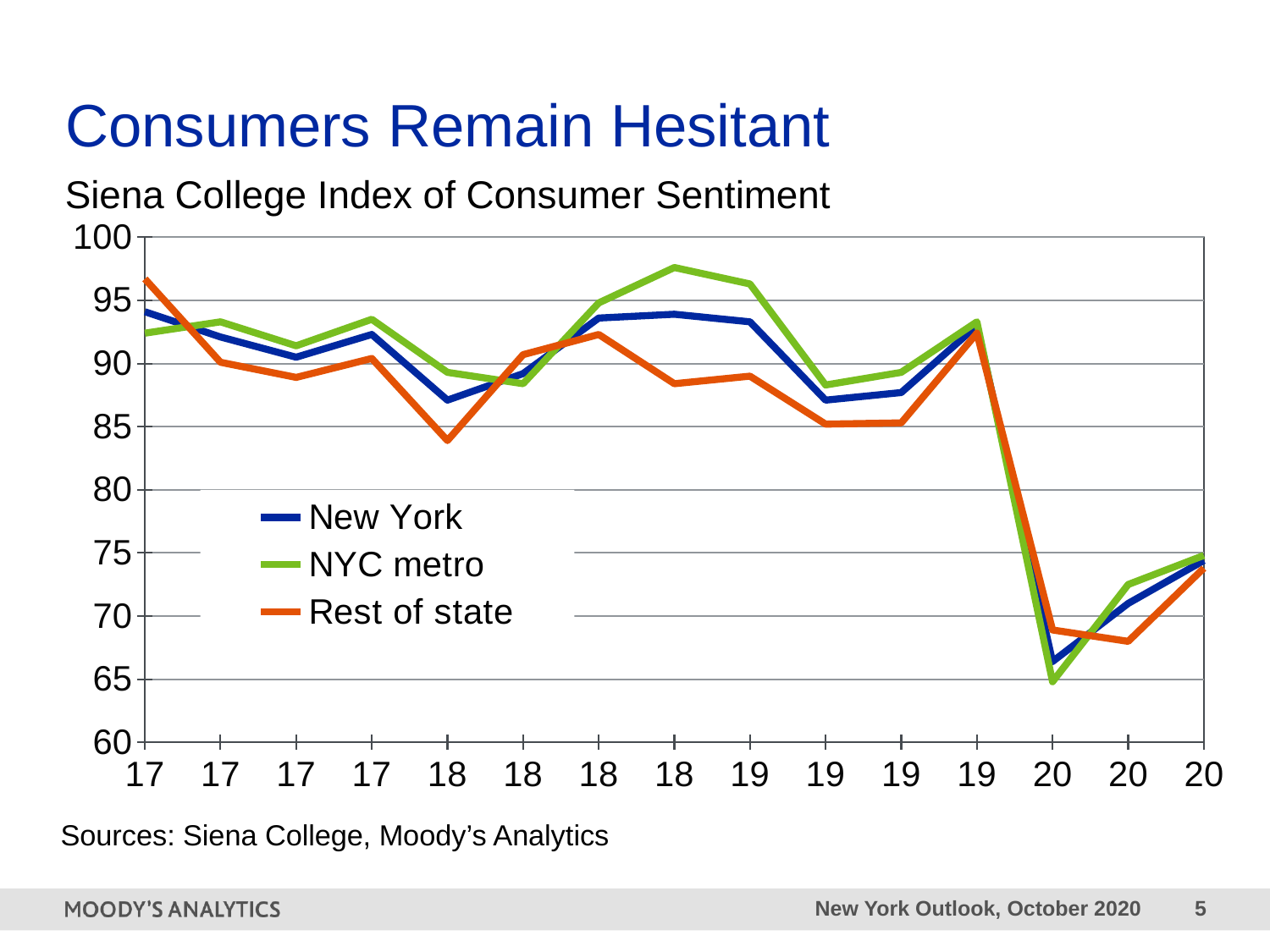
Is the value for NYC metro at its highest point (the fourth 18 label) greater or less than 95? greater How many points are plotted along the x axis for each series? 15 Do the values for all three series rise or fall between the last 19 label and the first 20 label? fall Is the value for New York at the first 20 label greater or less than 70? less Which series reaches the lowest value anywhere on the chart? NYC metro Which colour is used for the Rest of state series? orange At the fourth 18 label, which series is larger, NYC metro or Rest of state? NYC metro What kind of chart is shown on the slide? line chart How many series does the legend list? 3 Is the value for Rest of state at the first 17 label greater or less than 95? greater What is the title of the chart? Siena College Index of Consumer Sentiment